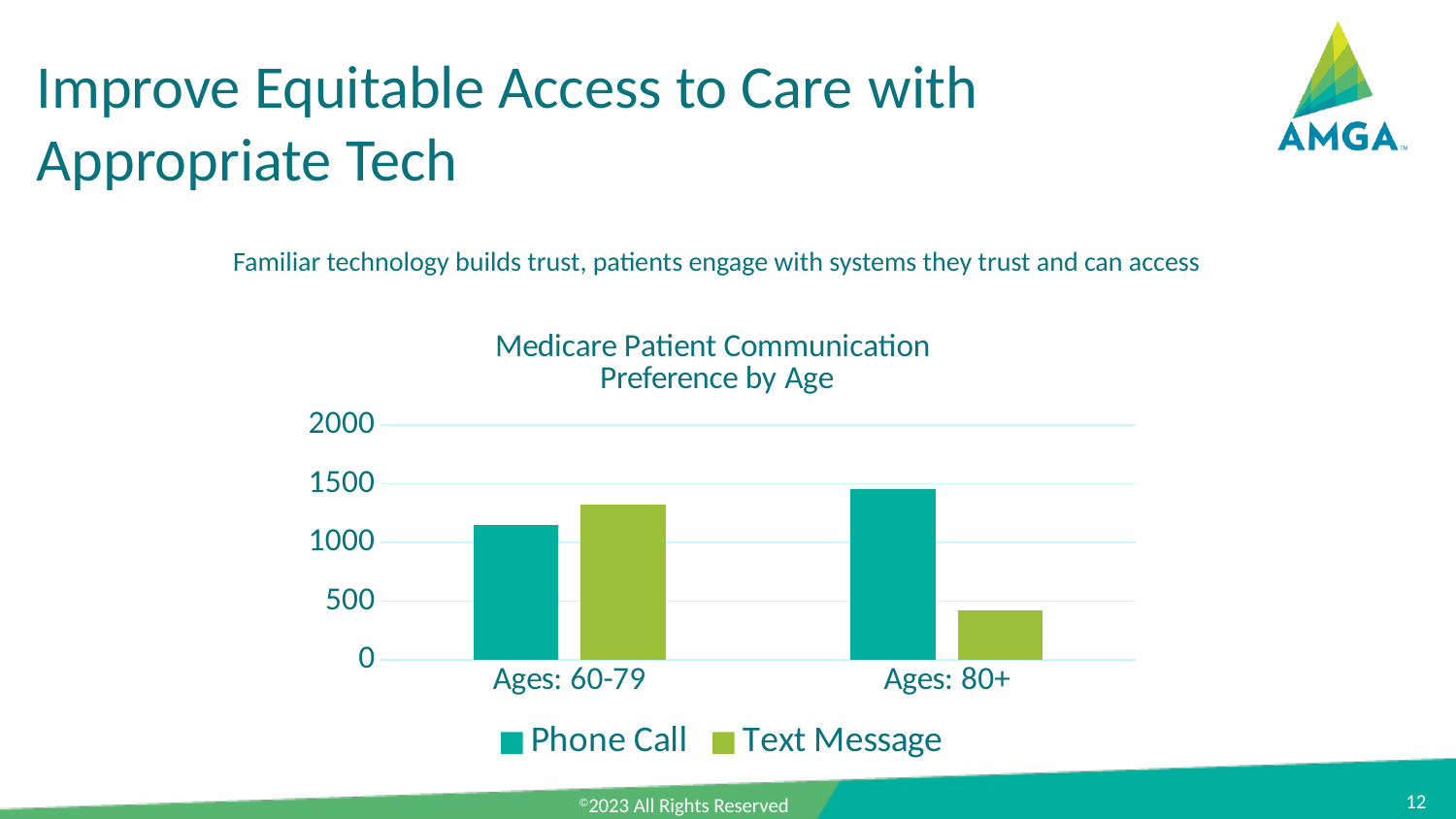
Is the Phone Call value for Ages: 80+ greater or less than 1000? greater What kind of chart is shown on the slide? bar chart Is the Text Message value for Ages: 60-79 greater or less than 1500? less What is the title of the chart? Medicare Patient Communication Preference by Age Which bar in the chart is the lowest? Text Message for Ages: 80+ How many series does the legend list? 2 For Ages: 80+, which is larger, Phone Call or Text Message? Phone Call How many age categories are shown on the x axis? 2 Is the Phone Call value for Ages: 60-79 greater or less than 1000? greater Which series are listed in the legend? Phone Call, Text Message For Ages: 60-79, which is larger, Phone Call or Text Message? Text Message